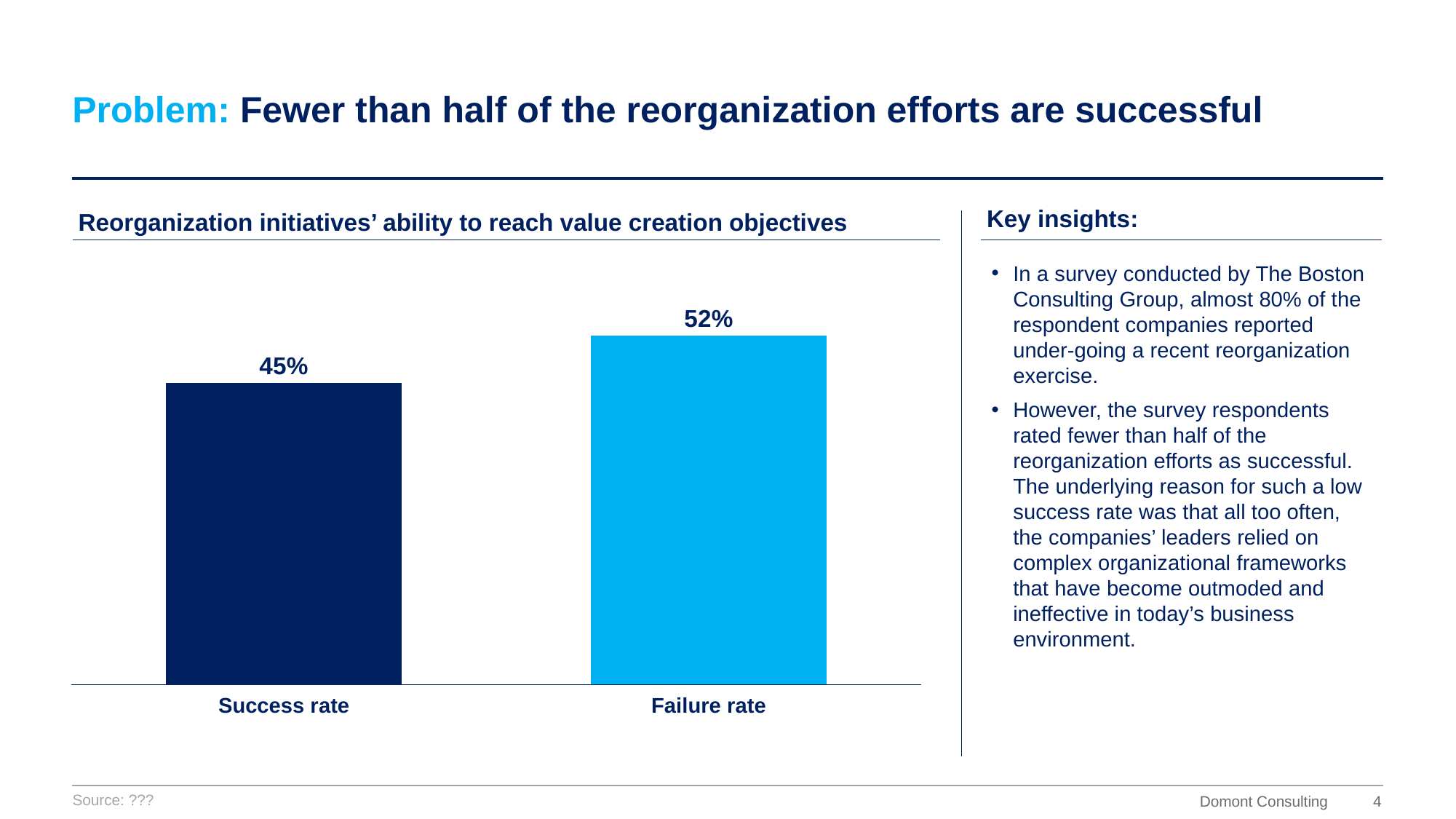
What colour is the bar for Failure rate? Light blue What is the value for Success rate? 45% What is the title of the chart? Reorganization initiatives' ability to reach value creation objectives Which category has the lowest value? Success rate Which category has the highest value? Failure rate Which is larger, the Success rate or the Failure rate? Failure rate How many categories are shown in the chart? 2 What is the difference between the Failure rate and the Success rate? 7% What kind of chart is shown on the slide? Bar chart What is the value for Failure rate? 52%